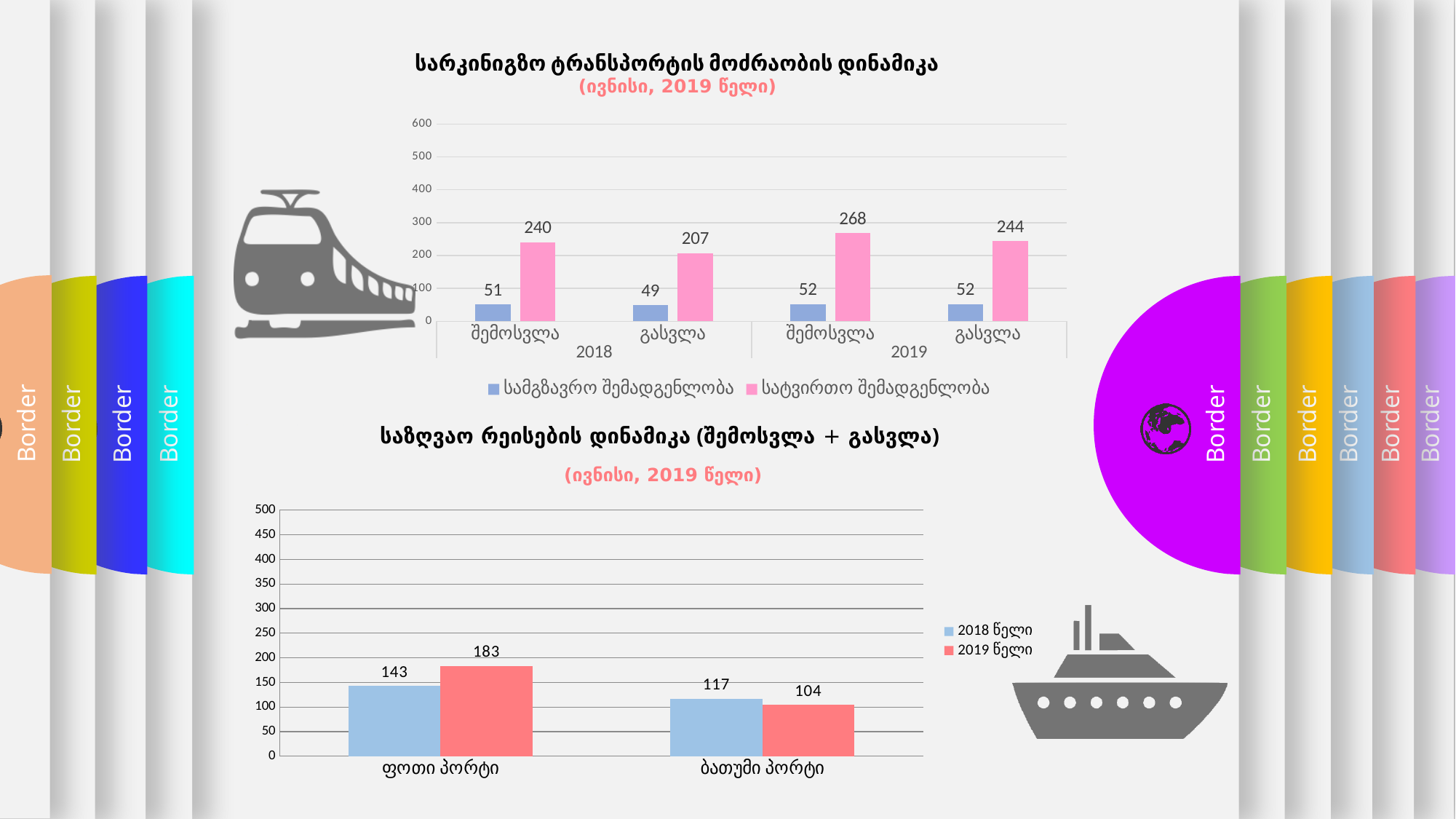
In the top chart, what is the difference between the სატვირთო შემადგენლობა values for შემოსვლა in 2019 and შემოსვლა in 2018? 28 In the bottom chart, how many port categories are shown on the x axis? 2 In the top chart, what is the value of სამგზავრო შემადგენლობა for გასვლა in 2018? 49 In the top chart, which category has the highest სატვირთო შემადგენლობა value? შემოსვლა 2019 In the top chart, how many series does the legend list? 2 In the bottom chart (საზღვაო რეისების დინამიკა), what is the value for ფოთი პორტი in 2019 წელი? 183 In the bottom chart, which is larger for ბათუმი პორტი: the 2018 წელი value or the 2019 წელი value? 2018 წელი In the bottom chart, what is the difference between the 2019 წელი and 2018 წელი values for ფოთი პორტი? 40 What type of chart is the bottom chart? bar chart In the top chart (სარკინიგზო ტრანსპორტის მოძრაობის დინამიკა), what is the value of სატვირთო შემადგენლობა for შემოსვლა in 2019? 268 In the bottom chart, what is the value for ბათუმი პორტი in 2018 წელი? 117 In the top chart, is the სატვირთო შემადგენლობა value for გასვლა in 2018 greater or less than 300? less